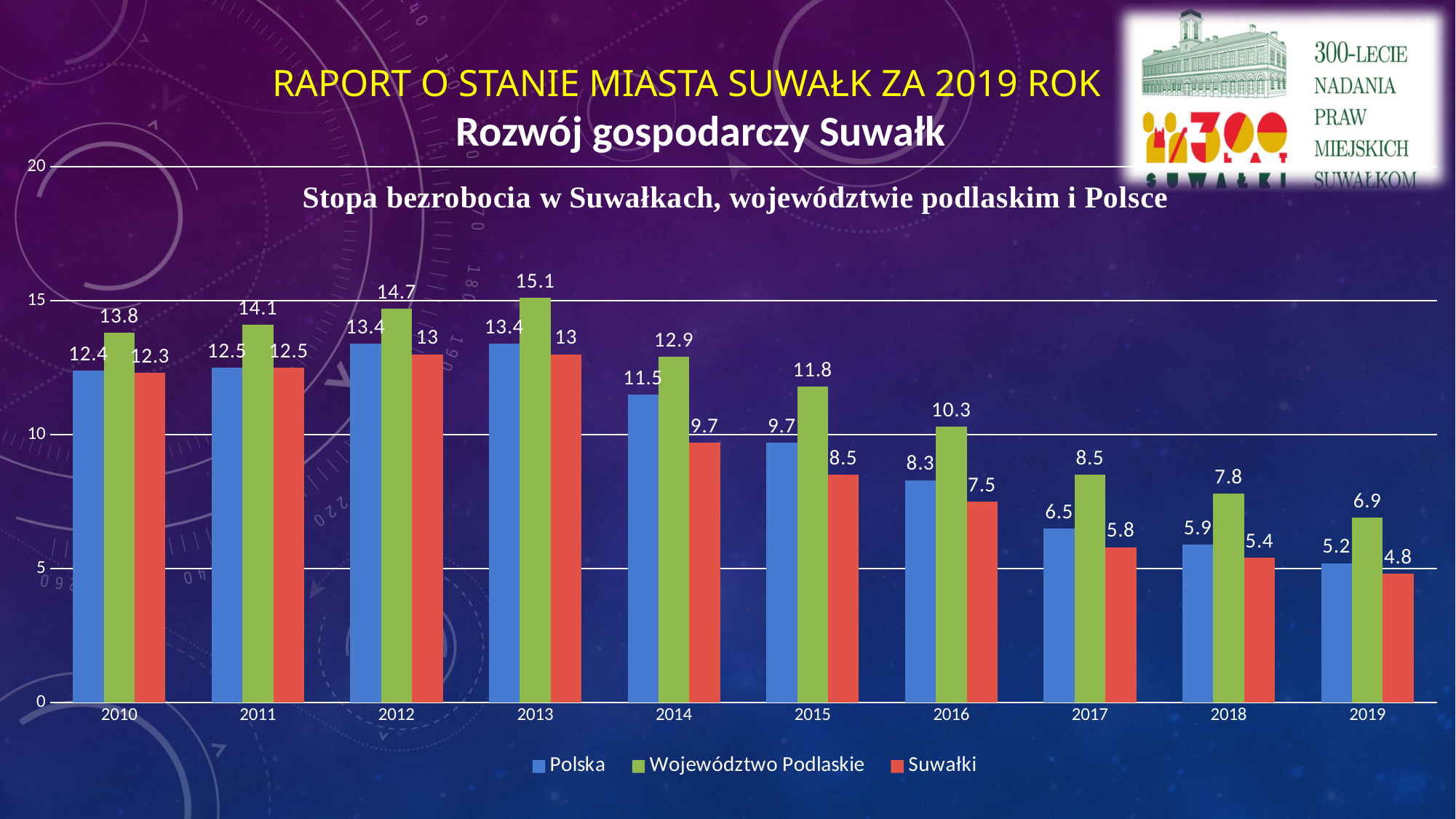
What is the unemployment rate for Suwałki in 2019? 4.8 In which year is the Województwo Podlaskie value highest? 2013 Do the Polska values rise or fall from 2013 to 2019? fall What is the difference between the Województwo Podlaskie and Suwałki values in 2015? 3.3 In 2014, which is larger: the value for Polska or for Suwałki? Polska What is the value for Polska in 2016? 8.3 In which year is the Suwałki value lowest? 2019 What kind of chart is shown on the slide? bar chart How many years are shown on the x axis? 10 Is the value for Województwo Podlaskie in 2012 greater or less than 10? greater How many series does the legend list? 3 What is the value for Województwo Podlaskie in 2013? 15.1